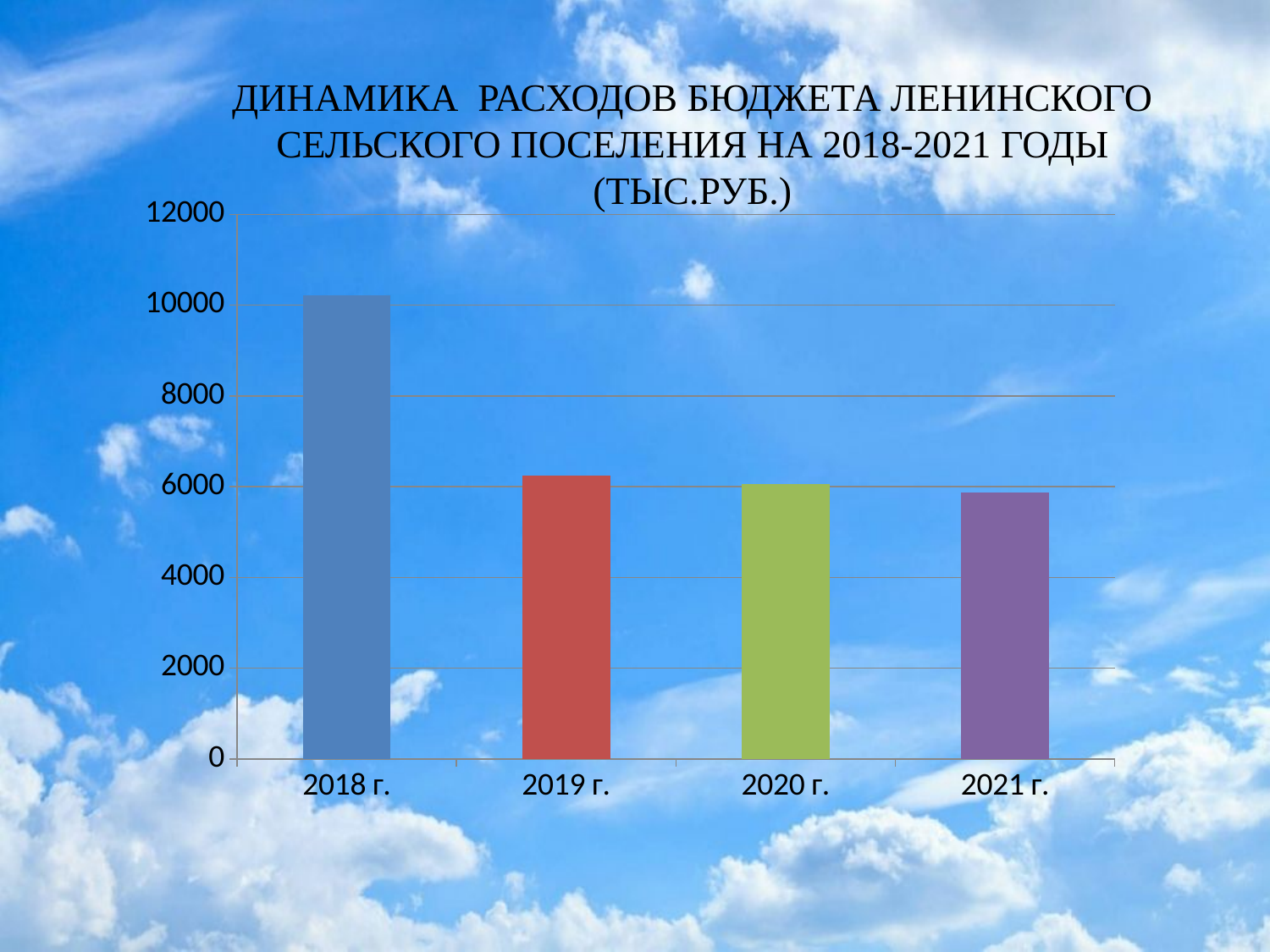
Which year has the lowest budget expenditure in the chart? 2021 г. Is the value for 2019 г. greater or less than 6000? greater Is the value for 2021 г. greater or less than 6000? less Is the value for 2018 г. greater or less than 12000? less Which year has the highest budget expenditure in the chart? 2018 г. What colour is the bar for 2018 г.? blue Do the values rise or fall from 2018 г. to 2021 г. along the x axis? fall How many years (categories) are shown on the x axis of the chart? 4 Which is larger, the value for 2018 г. or the value for 2019 г.? 2018 г. What kind of chart is shown on the slide? bar chart